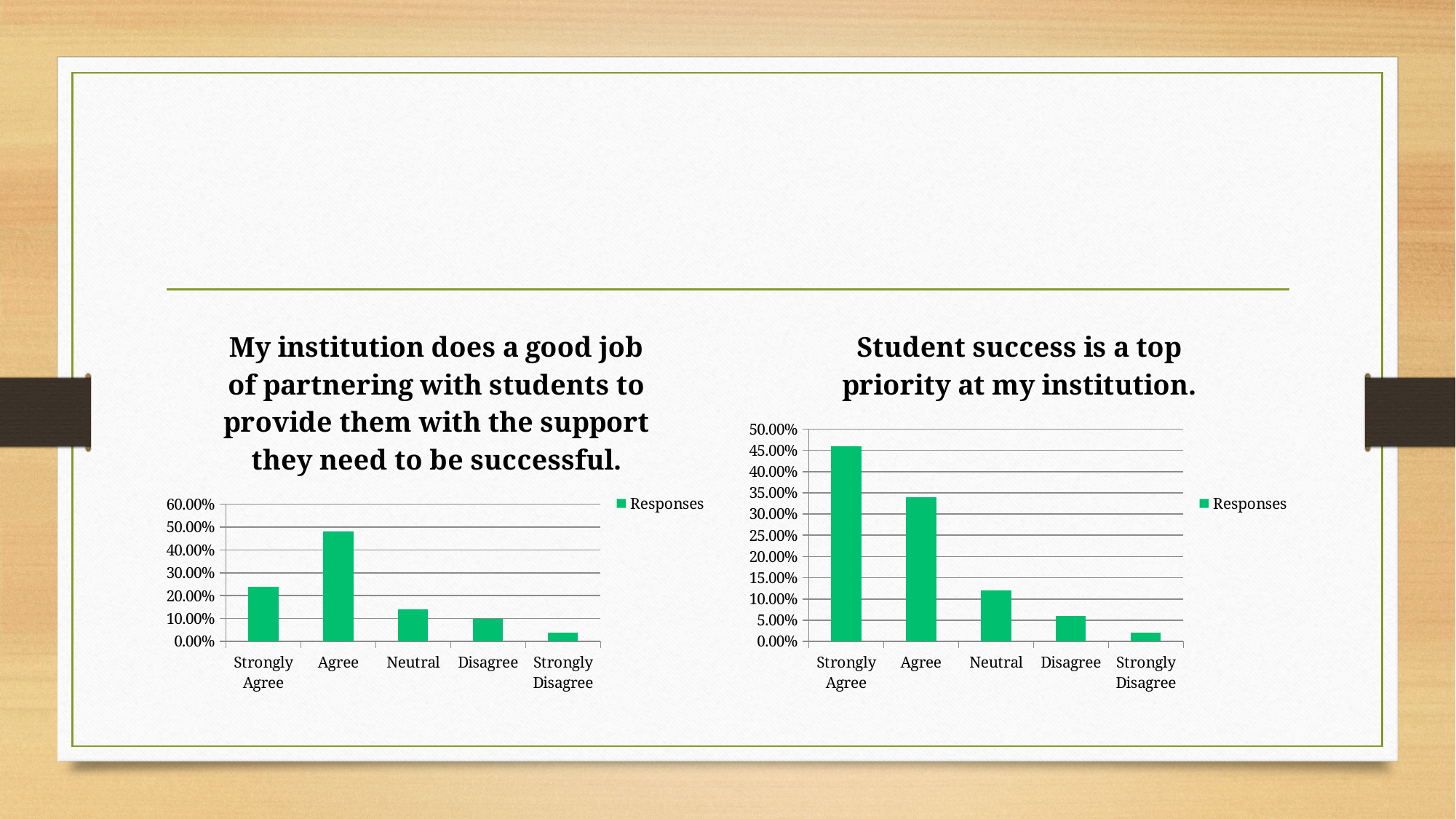
In the chart titled "Student success is a top priority at my institution.", which category has the highest value? Strongly Agree In the right chart, is the value for Neutral greater or less than 15.00%? less In the left chart, which is larger, the value for Strongly Agree or the value for Disagree? Strongly Agree In the left chart, is the value for Strongly Agree greater or less than 30.00%? less What kind of chart is the left chart on the slide? Bar chart In the chart titled "My institution does a good job of partnering with students to provide them with the support they need to be successful.", which category has the highest value? Agree In the chart titled "My institution does a good job of partnering with students to provide them with the support they need to be successful.", which category has the lowest value? Strongly Disagree How many categories are shown on the x axis of the chart titled "Student success is a top priority at my institution."? 5 In the right chart, is the value for Strongly Agree greater or less than 40.00%? greater In the chart titled "Student success is a top priority at my institution.", which category has the lowest value? Strongly Disagree In the right chart, which is larger, the value for Agree or the value for Neutral? Agree